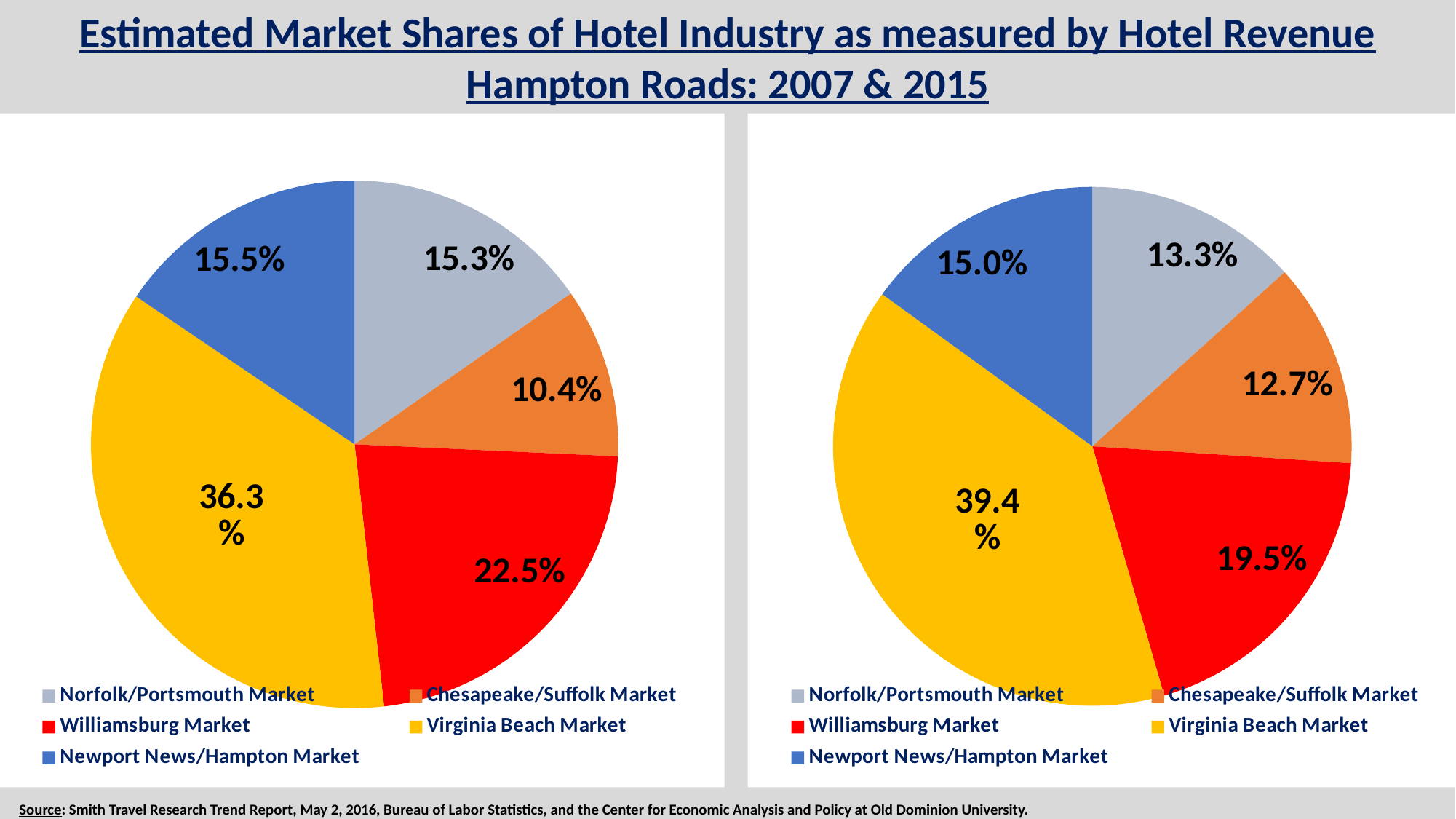
In the right pie chart, which is larger: the Williamsburg Market share or the Chesapeake/Suffolk Market share? Williamsburg Market In the right pie chart, what is the share for the Williamsburg Market? 19.5% What colour represents the Williamsburg Market in the legends? Red In the right pie chart, which market has the largest share? Virginia Beach Market What type of chart is shown on the right side of the slide? Pie chart In the left pie chart, what is the share for the Chesapeake/Suffolk Market? 10.4% In the left pie chart, which market has the smallest share? Chesapeake/Suffolk Market How many slices does the left pie chart have? 5 In the left pie chart, what is the share for the Virginia Beach Market? 36.3% In the right pie chart, what is the difference between the Virginia Beach Market share and the Newport News/Hampton Market share? 24.4% In the right pie chart, what is the share for the Norfolk/Portsmouth Market? 13.3% In the left pie chart, what is the difference between the Virginia Beach Market share and the Williamsburg Market share? 13.8%